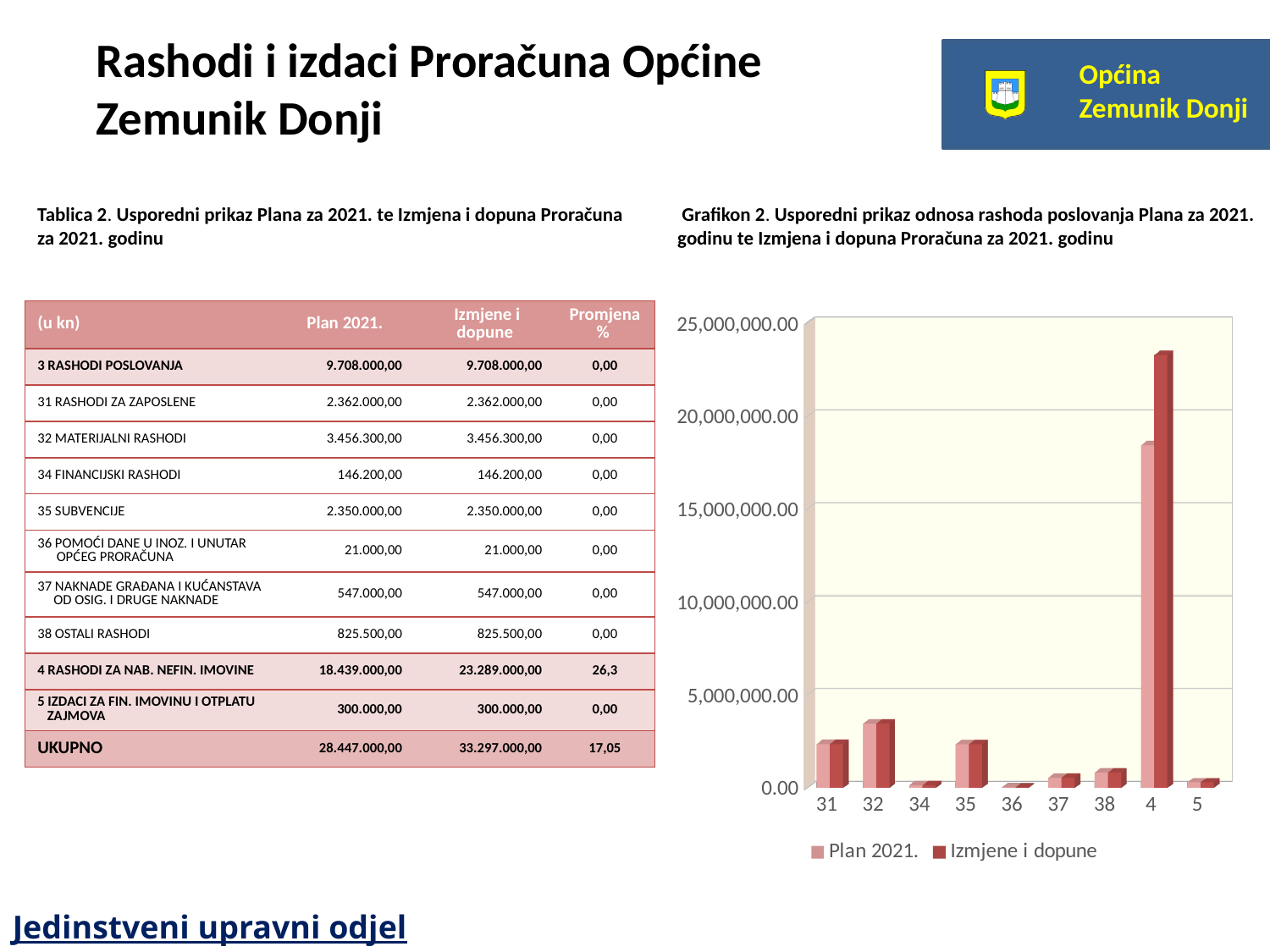
Is the Izmjene i dopune value for category 4 greater or less than 20,000,000.00? greater Which is larger in the chart, the Plan 2021. value for category 35 or for category 32? 32 How many series does the legend of the chart list? 2 Which is larger in the chart, the Plan 2021. value for category 31 or for category 32? 32 What are the two series named in the chart legend? Plan 2021. and Izmjene i dopune Is the Plan 2021. value for category 32 greater or less than 5,000,000.00? less Is the Plan 2021. value for category 4 greater or less than 20,000,000.00? less Which category has the highest bars in the chart? 4 What is the highest value labelled on the vertical axis of the chart? 25,000,000.00 For category 4, which series has the larger bar, Plan 2021. or Izmjene i dopune? Izmjene i dopune What kind of chart is Grafikon 2 on the slide? bar chart How many categories are shown on the x axis of the chart? 9